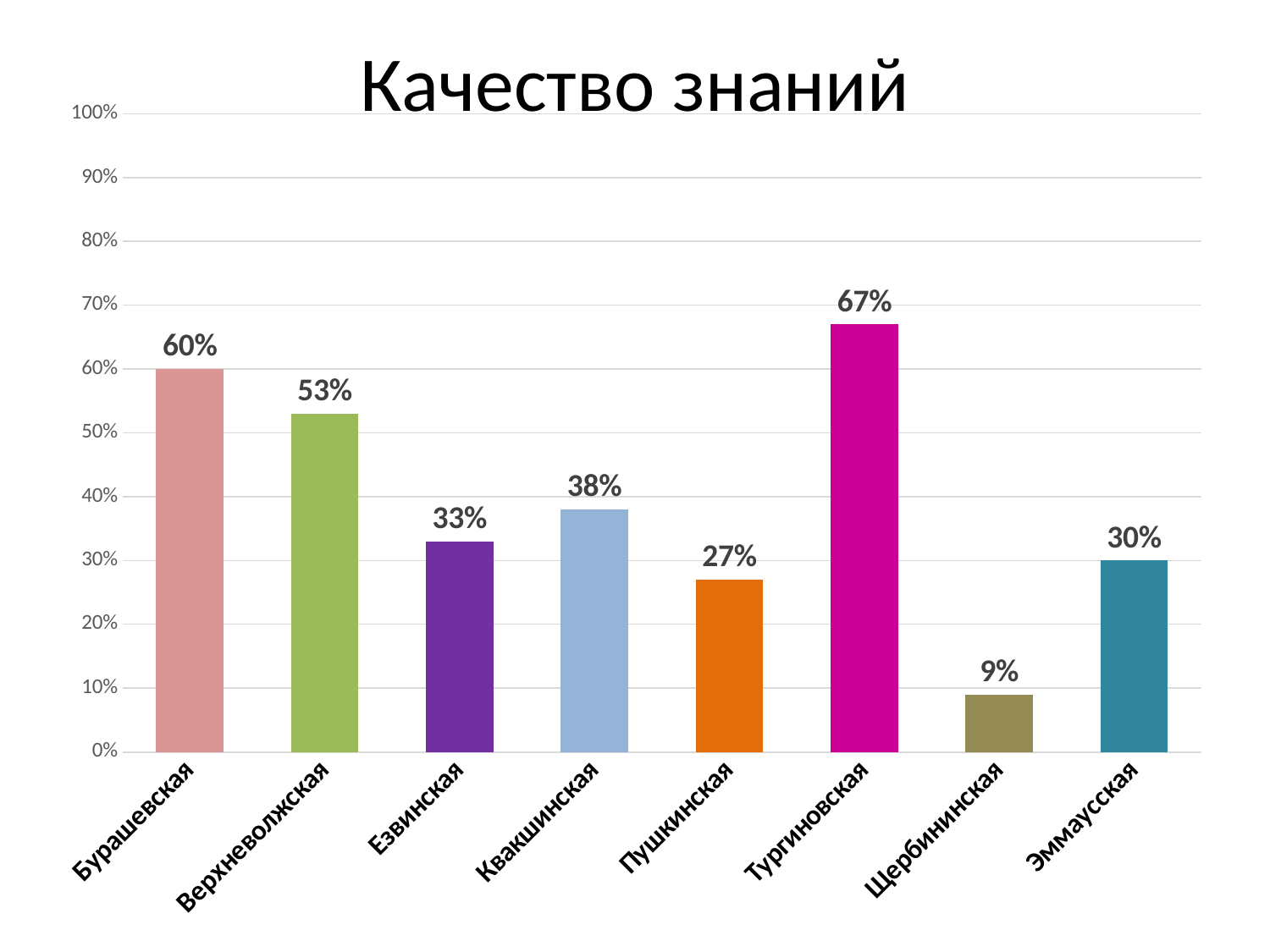
What kind of chart is shown on the slide? bar chart What is the value for Квакшинская? 38% Which is larger, the value for Езвинская or the value for Эммаусская? Езвинская What is the difference between the values for Тургиновская and Щербининская? 58% What is the difference between the values for Бурашевская and Верхневолжская? 7% What is the title of the chart? Качество знаний Which category has the lowest value? Щербининская How many categories are shown on the chart? 8 Which category has the highest value? Тургиновская What is the value for Тургиновская? 67% Is the value for Пушкинская greater or less than 30%? less What is the value for Щербининская? 9%